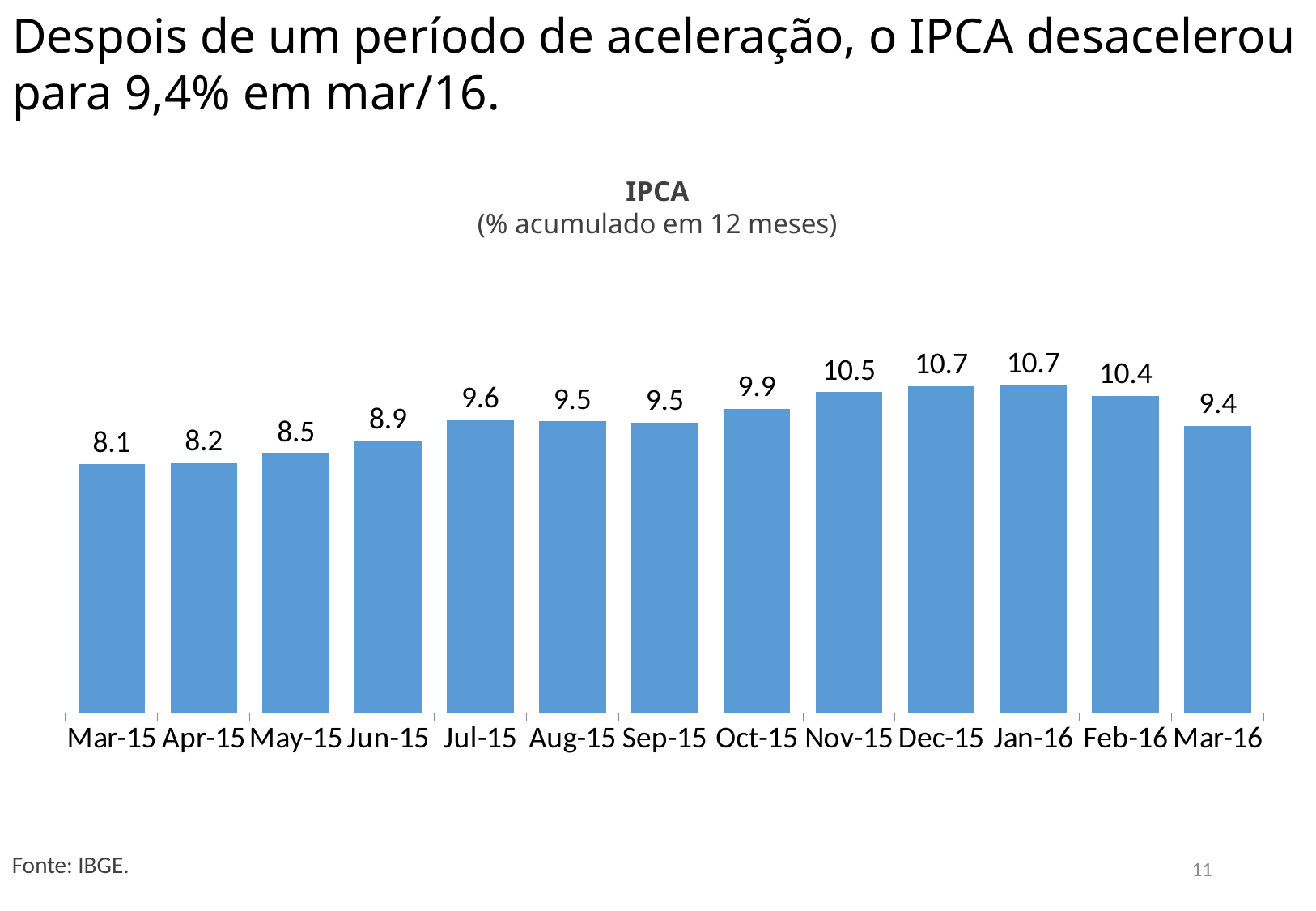
What is the difference between the IPCA values for Mar-15 and Dec-15? 2.6 What kind of chart is shown on the slide? Bar chart Which is larger, the IPCA value for Nov-15 or for Feb-16? Nov-15 What is the difference between the IPCA values for Jan-16 and Mar-16? 1.3 Which month has the lowest IPCA value? Mar-15 What is the highest IPCA value shown on the chart? 10.7 Do the IPCA values rise or fall from Mar-15 to Dec-15? Rise What is the IPCA value for Mar-16? 9.4 What is the title of the chart? IPCA (% acumulado em 12 meses) What is the IPCA value for Oct-15? 9.9 What is the IPCA value for Jun-15? 8.9 How many months are shown on the chart? 13